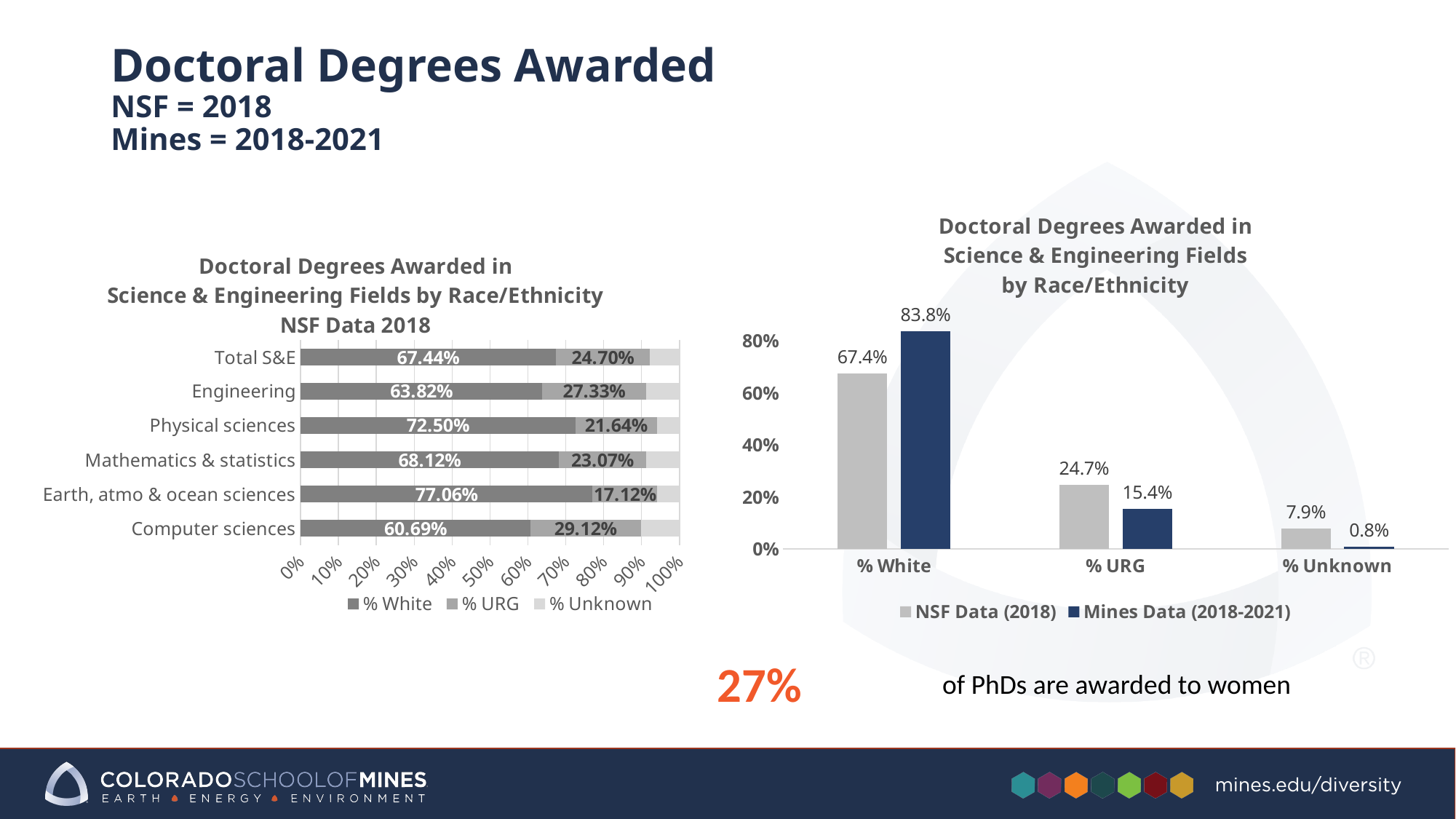
In the left chart (NSF Data 2018), which field has the highest % White value? Earth, atmo & ocean sciences In the left chart (NSF Data 2018), how many series does the legend list? 3 In the right chart (NSF vs Mines), what is the NSF Data (2018) value for % URG? 24.7% In the left chart (NSF Data 2018), is the % URG value for Engineering larger or smaller than that for Mathematics & statistics? larger In the left chart (NSF Data 2018), which field has the lowest % URG value? Earth, atmo & ocean sciences What kind of chart is the right chart (NSF vs Mines)? bar chart In the left chart (NSF Data 2018), what is the % White value for Physical sciences? 72.50% In the left chart (NSF Data 2018), what is the % URG value for Computer sciences? 29.12% In the right chart (NSF vs Mines), which category has the lowest Mines Data (2018-2021) value? % Unknown In the right chart (NSF vs Mines), what is the Mines Data (2018-2021) value for % White? 83.8% In the left chart (NSF Data 2018), how many fields are listed on the vertical axis? 6 In the right chart (NSF vs Mines), what is the difference between the NSF Data (2018) and Mines Data (2018-2021) values for % URG? 9.3%